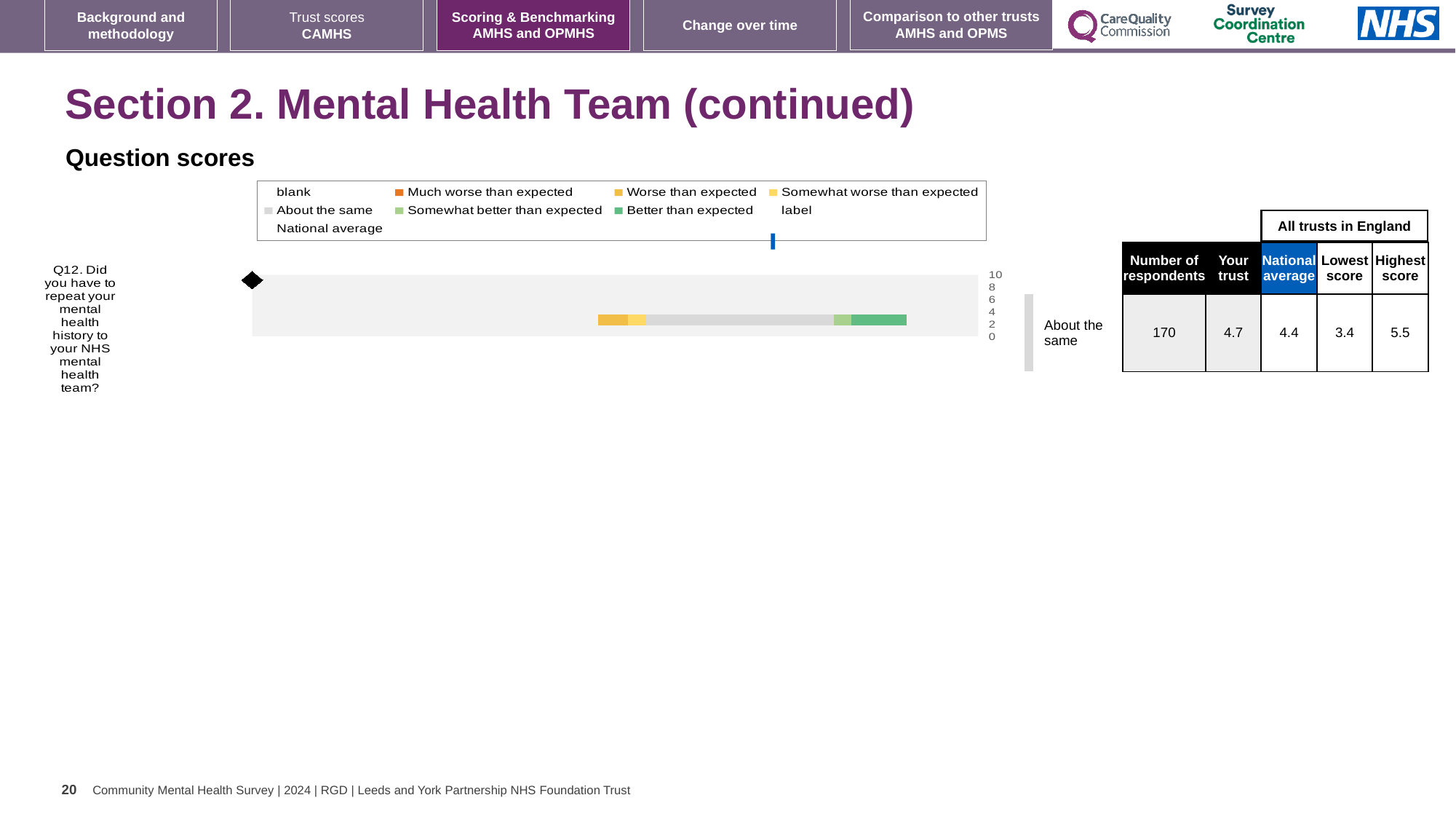
What is the lowest score among all trusts in England for Q12? 3.4 Which question is plotted in the chart? Q12. Did you have to repeat your mental health history to your NHS mental health team? What is the 'Your trust' score for Q12 in the table? 4.7 What is the difference between the 'Your trust' score and the national average for Q12? 0.3 What benchmark category is shown for Q12 next to the chart? About the same How many questions (categories) are plotted in the chart? 1 What is the highest score among all trusts in England for Q12? 5.5 What kind of chart is shown on the slide? bar chart How many entries does the chart legend list? 9 What is the national average score for Q12 in the table? 4.4 How many respondents answered Q12? 170 Which is larger for Q12, the 'Your trust' score or the national average? Your trust